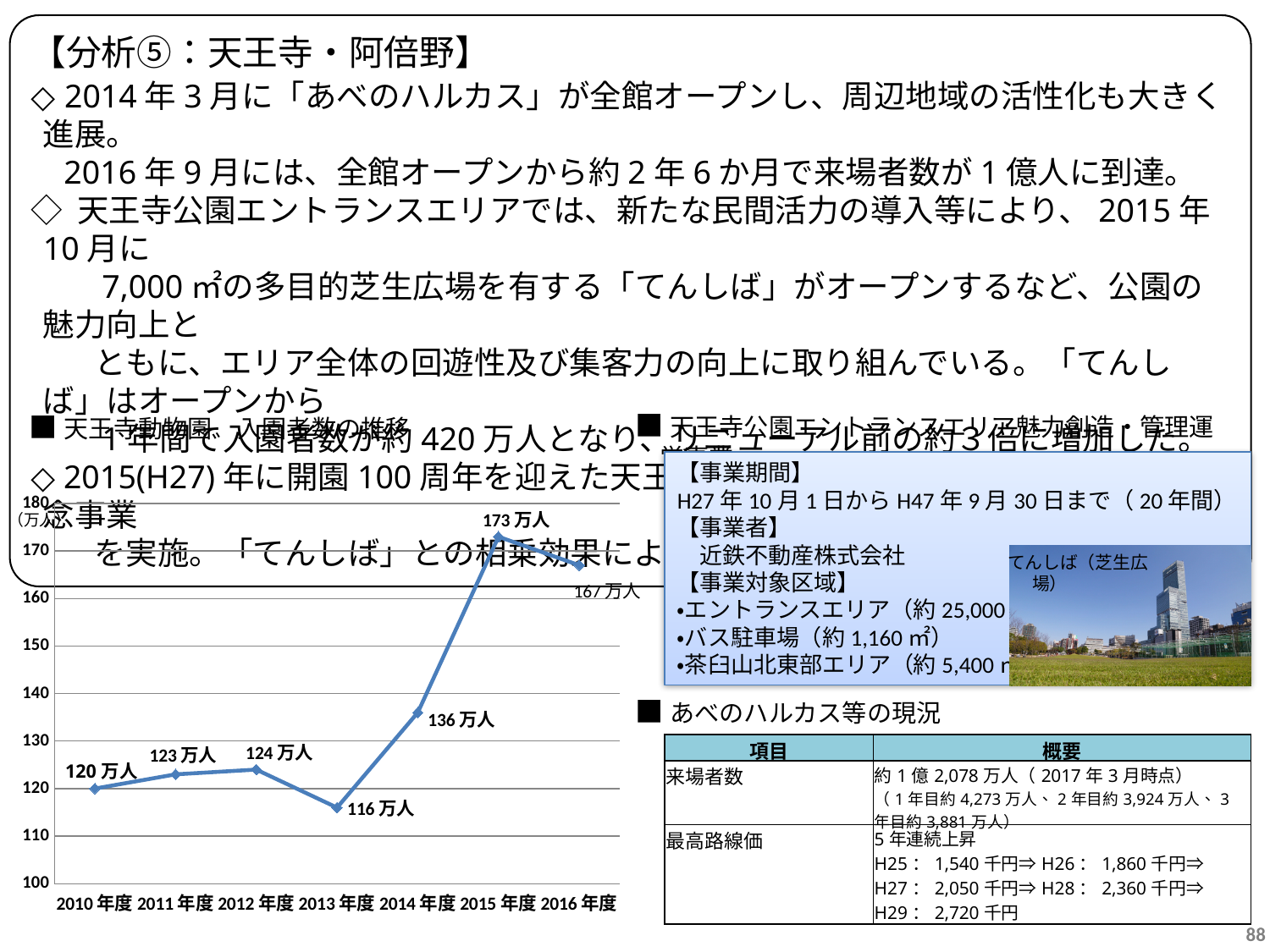
In the 天王寺動物園 入園者数の推移 chart, does the value rise or fall from 2015年度 to 2016年度? fall How many fiscal years are plotted in the 天王寺動物園 入園者数の推移 chart? 7 What unit is shown on the vertical axis of the 天王寺動物園 入園者数の推移 chart? 万人 In the 天王寺動物園 入園者数の推移 chart, what is the difference between the values for 2015年度 and 2014年度? 37万人 In the 天王寺動物園 入園者数の推移 chart, what is the value for 2010年度? 120万人 What kind of chart is used to show the 天王寺動物園 入園者数の推移? line chart In the 天王寺動物園 入園者数の推移 chart, is the value for 2014年度 greater or less than 130? greater In the 天王寺動物園 入園者数の推移 chart, which fiscal year has the highest value? 2015年度 In the 天王寺動物園 入園者数の推移 chart, which is larger, the value for 2011年度 or 2012年度? 2012年度 In the 天王寺動物園 入園者数の推移 chart, what is the value for 2016年度? 167万人 In the 天王寺動物園 入園者数の推移 chart, what is the value for 2013年度? 116万人 In the 天王寺動物園 入園者数の推移 chart, which fiscal year has the lowest value? 2013年度